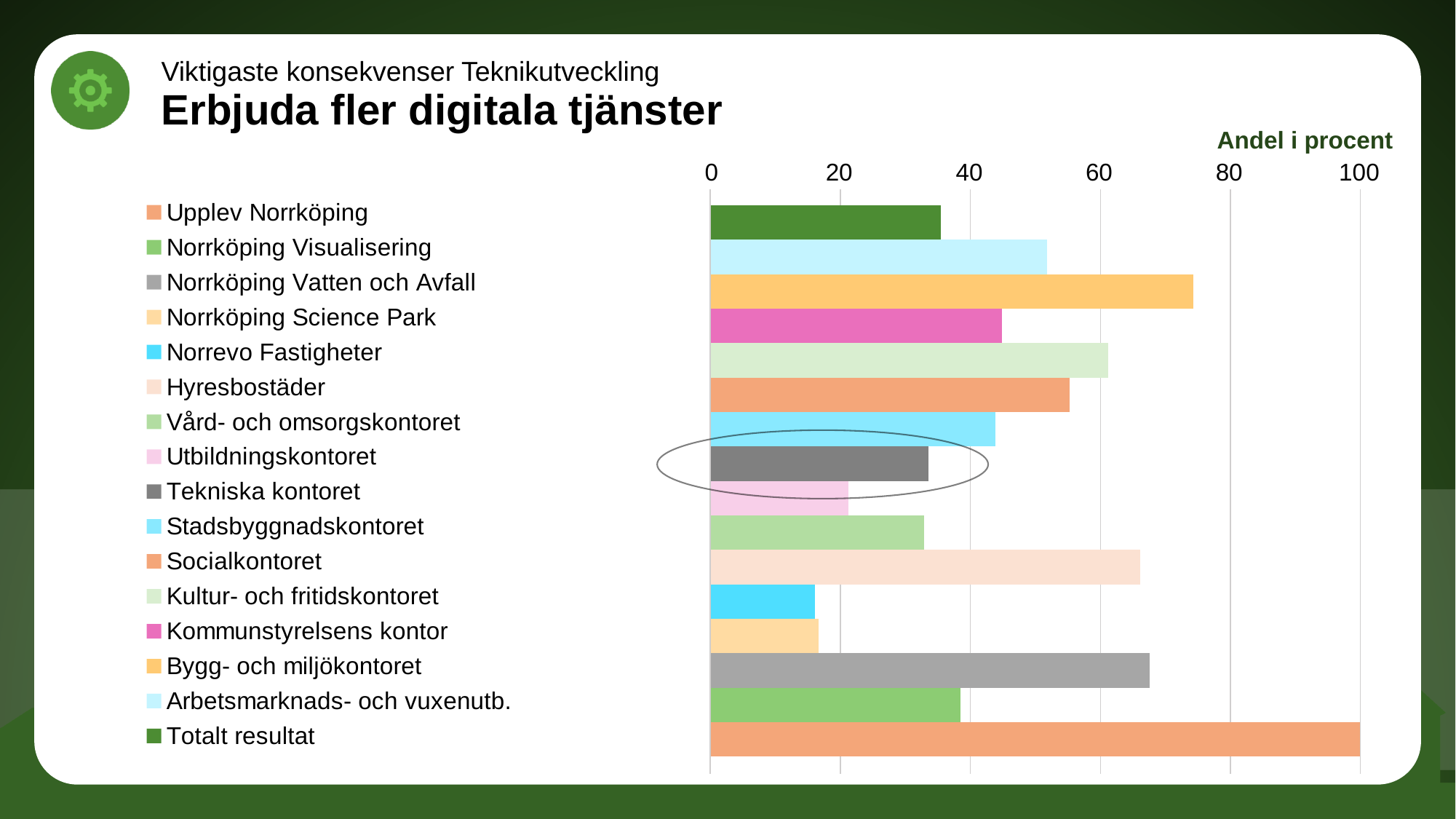
What is the label shown above the horizontal axis of the chart? Andel i procent Which category has the highest value in the chart? Upplev Norrköping What is the value for Upplev Norrköping? 100 Which is larger, the value for Hyresbostäder or the value for Utbildningskontoret? Hyresbostäder Which is larger, the value for Bygg- och miljökontoret or the value for Kommunstyrelsens kontor? Bygg- och miljökontoret How many bars are plotted in the chart? 16 Is the value for Totalt resultat greater or less than 40? less How many entries does the legend list? 16 Is the value for Norrevo Fastigheter greater or less than 20? less Is the value for Bygg- och miljökontoret greater or less than 60? greater What kind of chart is shown on the slide? bar chart